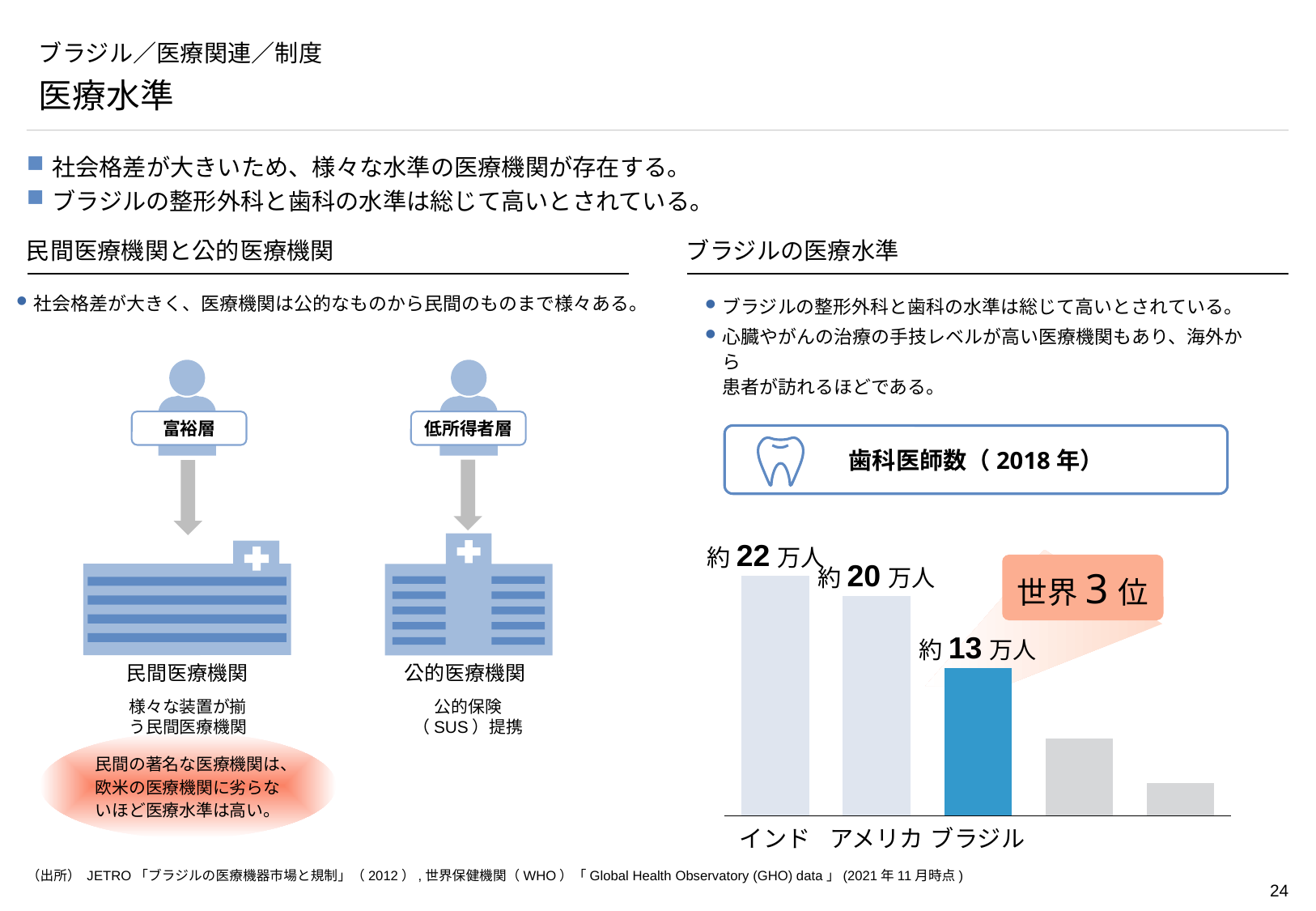
In the 歯科医師数 chart, which of the three named countries has the lowest number of dentists? ブラジル In the 歯科医師数 chart, which named country has the highest number of dentists? インド In the 歯科医師数 chart, which is larger, the value for インド or the value for アメリカ? インド In the 歯科医師数 chart, do the values rise or fall from インド to ブラジル along the x axis? fall In the 歯科医師数 chart, what value is labeled for インド? 約22万人 In the 歯科医師数 chart, how many countries are named on the x axis? 3 In the 歯科医師数 chart, what world ranking is shown in the callout next to the ブラジル bar? 世界3位 What kind of chart is shown under 歯科医師数（2018年）? bar chart In the 歯科医師数 chart, what value is labeled for ブラジル? 約13万人 In the 歯科医師数 chart, which country's bar is highlighted in blue? ブラジル What is the title of the chart on the right side of the slide? 歯科医師数（2018年） In the 歯科医師数 chart, what value is labeled for アメリカ? 約20万人